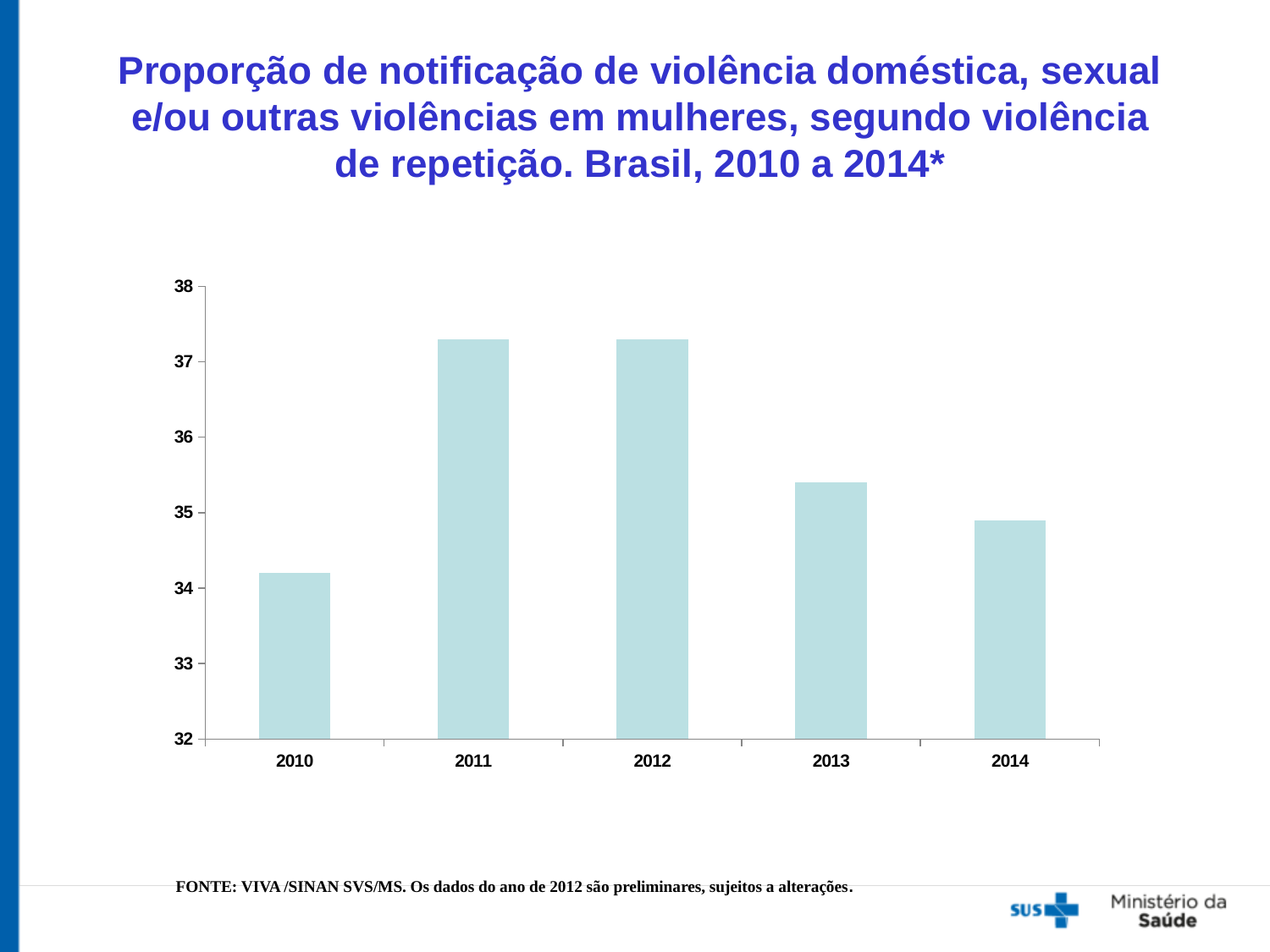
Which is larger, the value for 2013 or the value for 2014? 2013 Is the value for 2011 greater or less than 37? greater How many years are shown on the x axis of the chart? 5 Which is larger, the value for 2010 or the value for 2011? 2011 What is the first year shown on the x axis of the chart? 2010 Which year has the lowest bar in the chart? 2010 What kind of chart is shown on the slide? bar chart Is the value for 2010 greater or less than 35? less Do the values rise or fall from 2012 to 2014? fall Is the value for 2012 greater or less than 36? greater